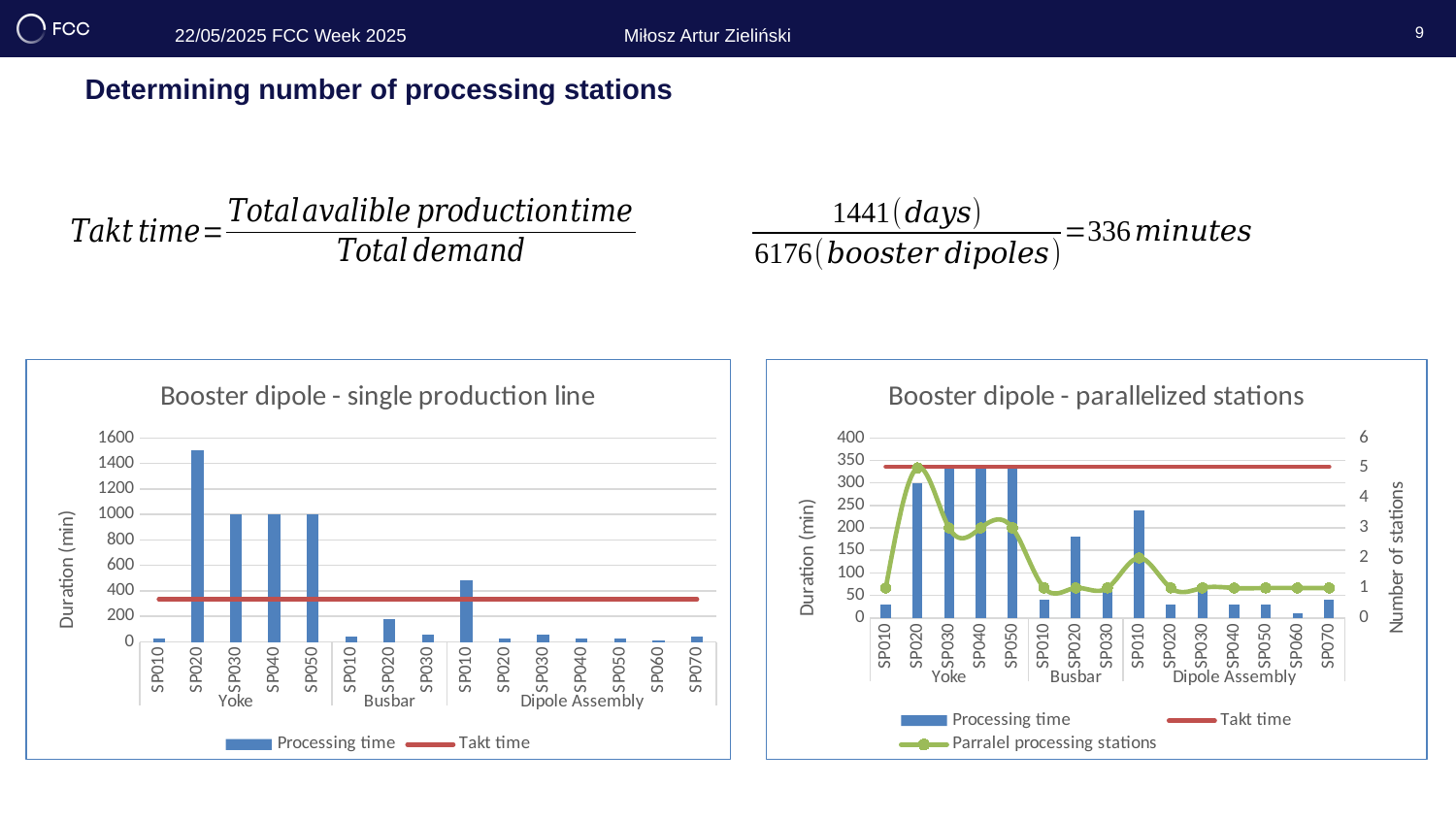
In the 'Booster dipole - single production line' chart, which has the larger processing time, Yoke SP020 or Dipole Assembly SP010? Yoke SP020 In the 'Booster dipole - single production line' chart, which station has the highest processing time? Yoke SP020 In the 'Booster dipole - single production line' chart, is the processing time for Yoke SP020 greater or less than 1400? greater In the 'Booster dipole - single production line' chart, how many station categories are shown on the x axis? 15 In the 'Booster dipole - parallelized stations' chart, how many parallel processing stations are shown for Yoke SP020? 5 In the 'Booster dipole - parallelized stations' chart, which station has the highest number of parallel processing stations? Yoke SP020 In the 'Booster dipole - single production line' chart, what kind of chart is used to show the processing time? bar chart In the 'Booster dipole - parallelized stations' chart, how many parallel processing stations are shown for Dipole Assembly SP010? 2 In the 'Booster dipole - parallelized stations' chart, is the processing time for Busbar SP020 greater or less than 150? greater In the 'Booster dipole - single production line' chart, how many series does the legend list? 2 In the 'Booster dipole - parallelized stations' chart, how many series does the legend list? 3